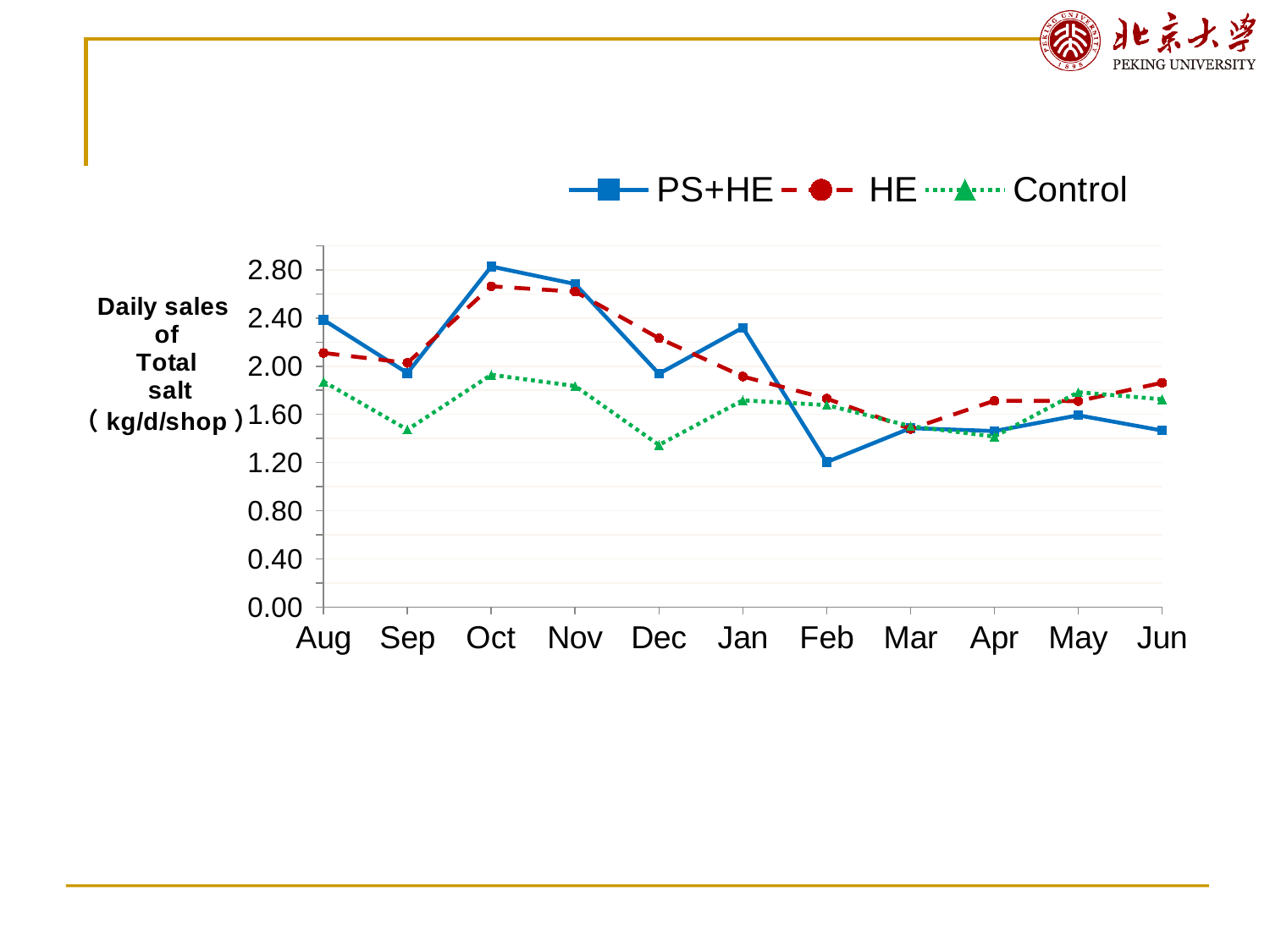
Does the HE series rise or fall from Oct to Mar? Fall In Jan, which series has the larger value, PS+HE or HE? PS+HE In which month does the PS+HE series reach its lowest value? Feb In which month does the HE series reach its lowest value? Mar Is the value for PS+HE in Oct greater or less than 2.40? greater What kind of chart is shown on the slide? Line chart What is the label on the vertical axis of the chart? Daily sales of Total salt (kg/d/shop) In which month does the PS+HE series reach its highest value? Oct Is the value for Control in Dec greater or less than 1.60? less How many series does the legend list? 3 How many months are shown along the x axis? 11 Is the value for PS+HE in Feb greater or less than 1.60? less